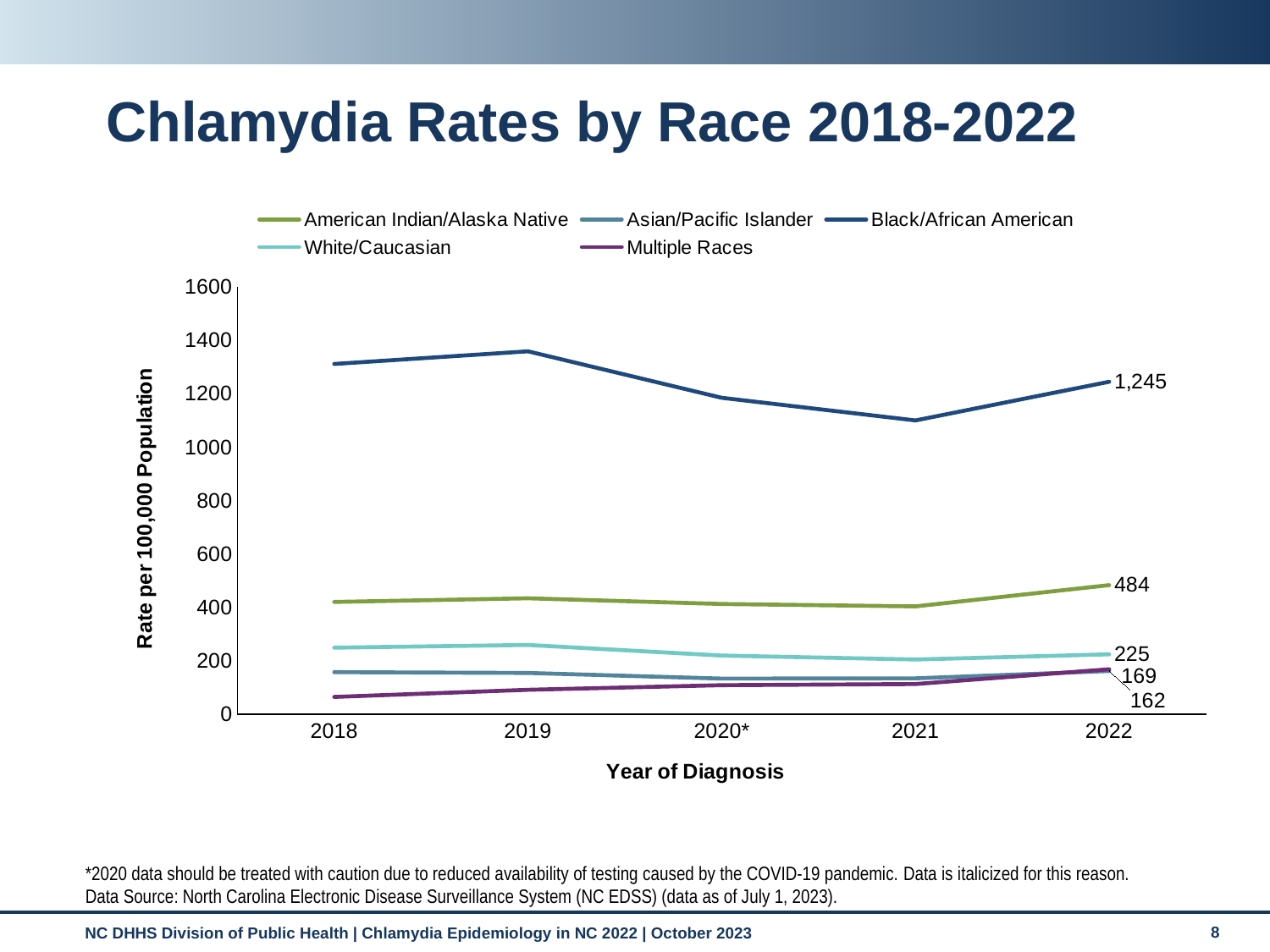
What is the chlamydia rate for Black/African American in 2022? 1,245 What is the difference between the 2022 rates for Black/African American and American Indian/Alaska Native? 761 What is the chlamydia rate for American Indian/Alaska Native in 2022? 484 Which race has the highest chlamydia rate in 2022? Black/African American How many years are shown on the x axis? 5 Which race has the lowest chlamydia rate in 2018? Multiple Races Does the Black/African American rate rise or fall from 2019 to 2021? fall How many series does the legend list? 5 Is the value for Black/African American in 2019 greater or less than 1200? greater Is the value for Black/African American in 2021 greater or less than 1200? less What type of chart is shown on the slide? line chart What is the chlamydia rate for White/Caucasian in 2022? 225